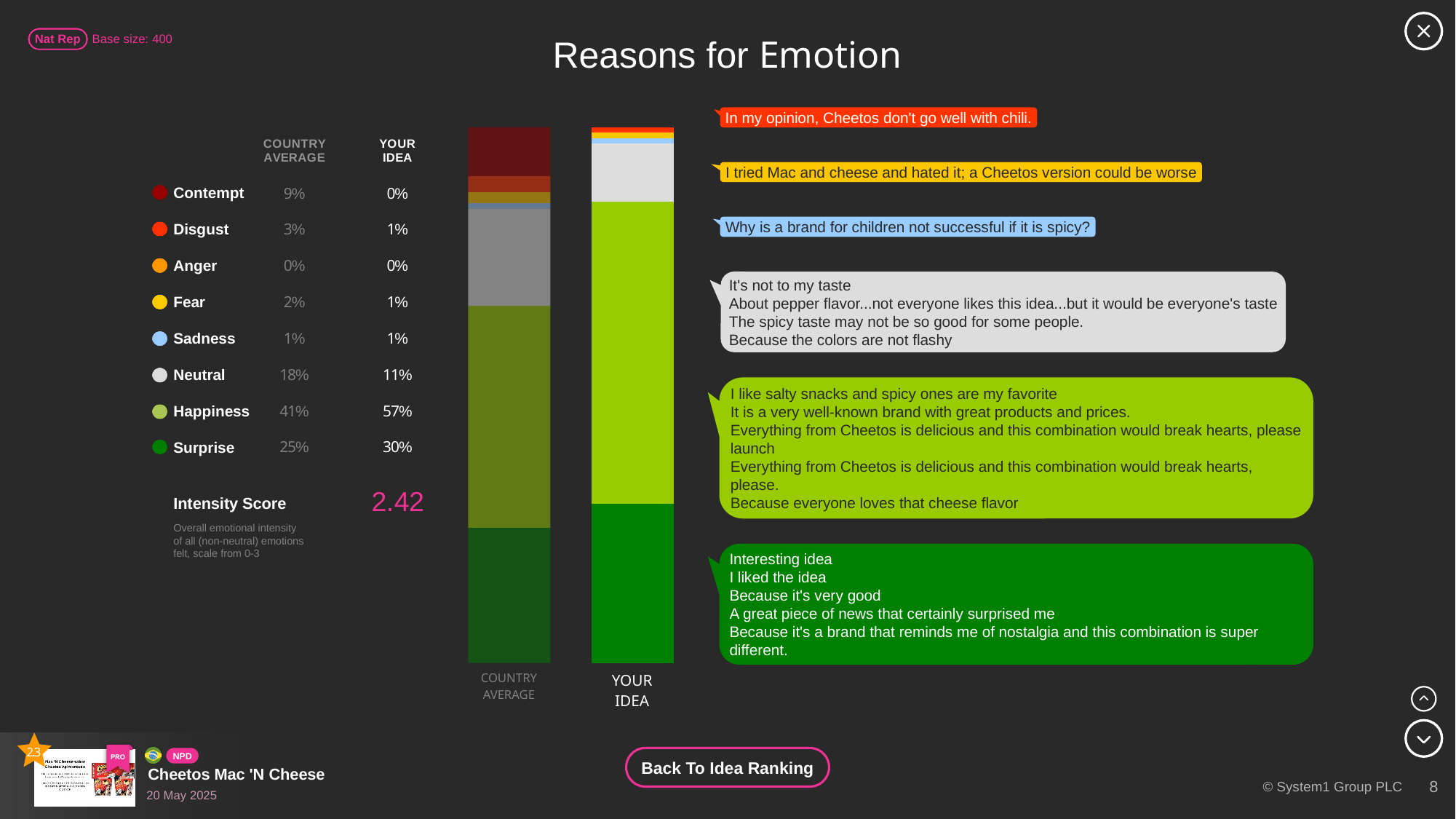
What is the difference between the Neutral value for the Country Average and Your Idea? 7 percentage points What is the Happiness value for Your Idea? 57% What is the Neutral value for the Country Average? 18% Is the Surprise value larger for Your Idea or for the Country Average? Your Idea What is the Contempt value for the Country Average? 9% Which emotion has the largest share in the Country Average bar? Happiness What is the difference between the Happiness value for Your Idea and the Country Average? 16 percentage points What kind of chart is shown on the slide? Stacked bar chart What is the Surprise value for Your Idea? 30% How many emotion categories are listed in the chart? 8 Which emotion has the largest share in the Your Idea bar? Happiness What is the Intensity Score shown on the slide? 2.42